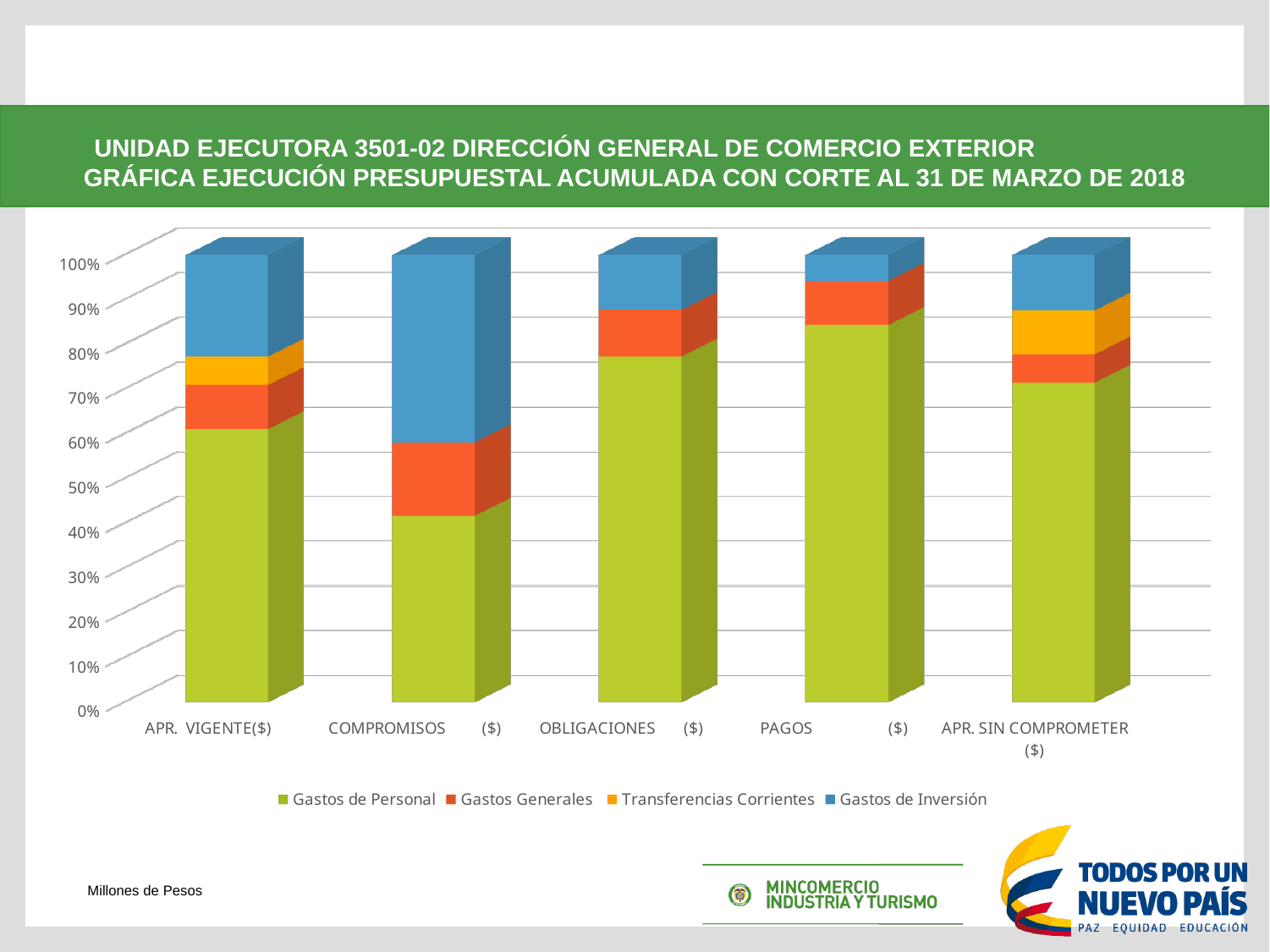
Which is larger: the Gastos de Personal share for COMPROMISOS ($) or for PAGOS ($)? PAGOS ($) Which category has the smallest Gastos de Personal share? COMPROMISOS ($) Is the Gastos de Personal share for COMPROMISOS ($) greater or less than 50%? less Is the Gastos de Personal share for OBLIGACIONES ($) greater or less than 70%? greater What kind of chart is shown on the slide? Stacked bar chart How many series does the chart legend list? 4 Which category has the largest Gastos de Inversión share? COMPROMISOS ($) Is the Gastos de Personal share for PAGOS ($) greater or less than 80%? greater Which series is shown in blue in the chart legend? Gastos de Inversión What is the total height of each stacked bar in the chart? 100% Which category has the largest Gastos de Personal share? PAGOS ($) How many categories are shown along the x axis of the chart? 5